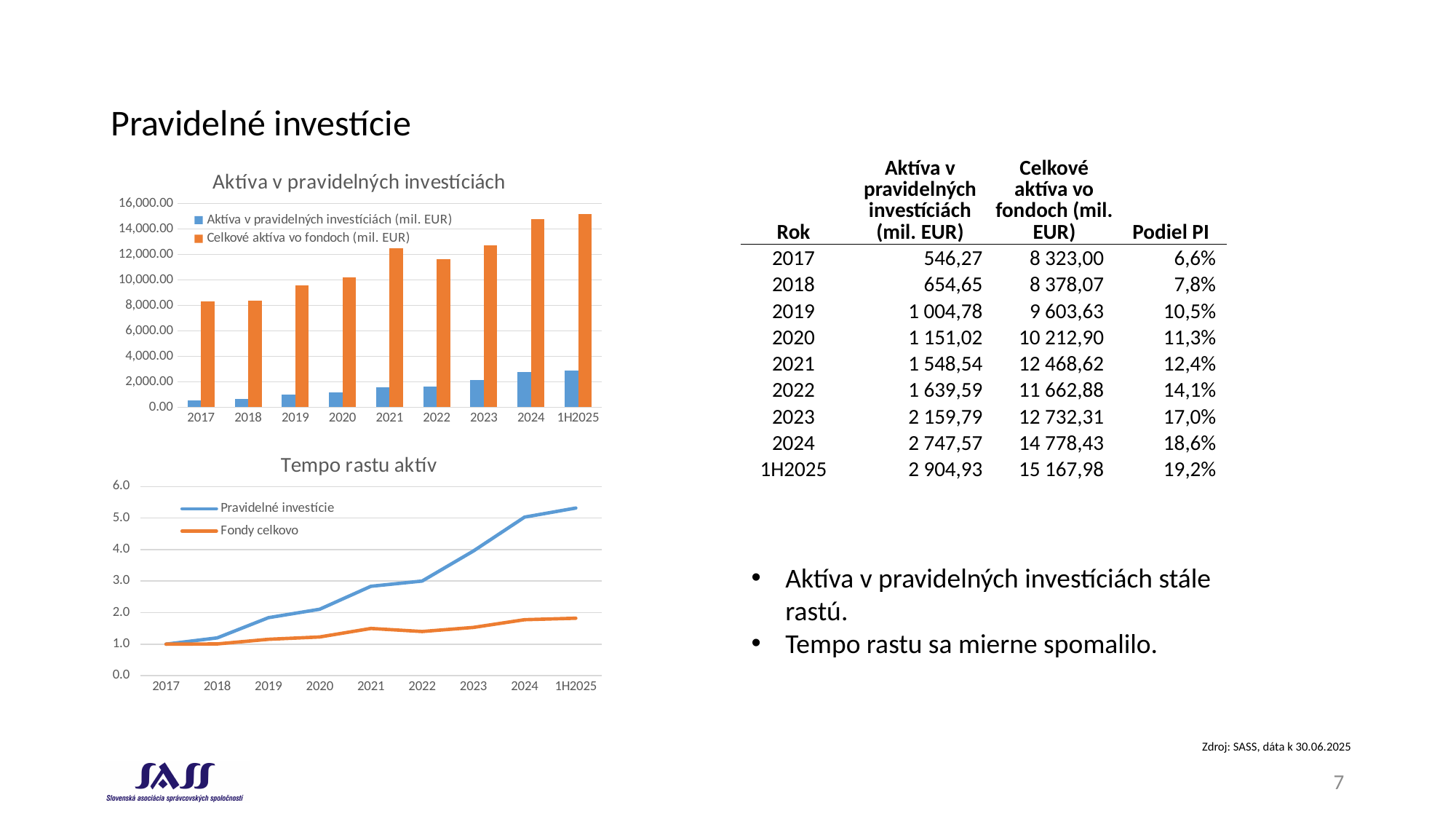
What kind of chart is the 'Aktíva v pravidelných investíciách' chart? bar chart In the 'Tempo rastu aktív' chart, what is the value of 'Pravidelné investície' in 2017? 1.0 What kind of chart is the 'Tempo rastu aktív' chart? line chart In the 'Aktíva v pravidelných investíciách' chart, which is larger for 'Celkové aktíva vo fondoch (mil. EUR)': 2021 or 2022? 2021 In the 'Aktíva v pravidelných investíciách' chart, which year has the highest value for 'Celkové aktíva vo fondoch (mil. EUR)'? 1H2025 In the 'Tempo rastu aktív' chart, does the 'Pravidelné investície' line generally rise or fall from 2017 to 1H2025? rise In the 'Tempo rastu aktív' chart, which series is higher in 2024: 'Pravidelné investície' or 'Fondy celkovo'? Pravidelné investície In the 'Aktíva v pravidelných investíciách' chart, how many series does the legend list? 2 In the 'Tempo rastu aktív' chart, how many categories are shown on the x axis? 9 In the 'Aktíva v pravidelných investíciách' chart, is the value for 'Aktíva v pravidelných investíciách (mil. EUR)' in 2024 greater or less than 4,000.00? less In the 'Aktíva v pravidelných investíciách' chart, which year has the lowest value for 'Aktíva v pravidelných investíciách (mil. EUR)'? 2017 In the 'Aktíva v pravidelných investíciách' chart, is the value for 'Celkové aktíva vo fondoch (mil. EUR)' in 2021 greater or less than 12,000.00? greater